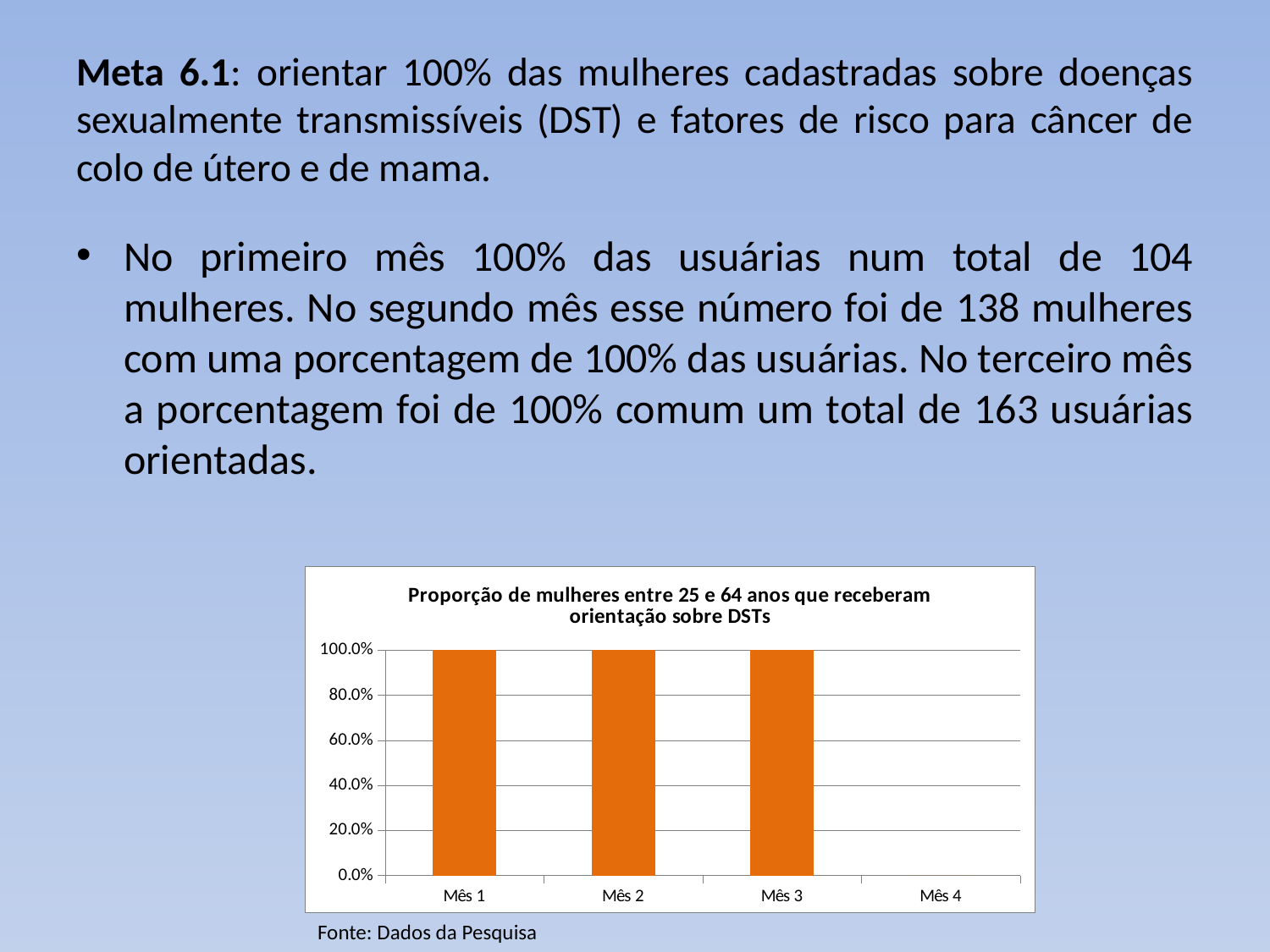
Is the value for Mês 2 greater or less than 80.0%? greater What is the title of the chart? Proporção de mulheres entre 25 e 64 anos que receberam orientação sobre DSTs What is the highest value shown on the y axis of the chart? 100.0% Is the value for Mês 3 greater or less than 60.0%? greater What is the value for Mês 2 in the chart? 100.0% Do the values rise, fall or stay the same from Mês 1 to Mês 3? stay the same How many categories are shown on the x axis of the chart? 4 Which category has no bar plotted in the chart? Mês 4 What kind of chart is shown on the slide? bar chart What is the value for Mês 1 in the chart? 100.0% What is the value for Mês 3 in the chart? 100.0%